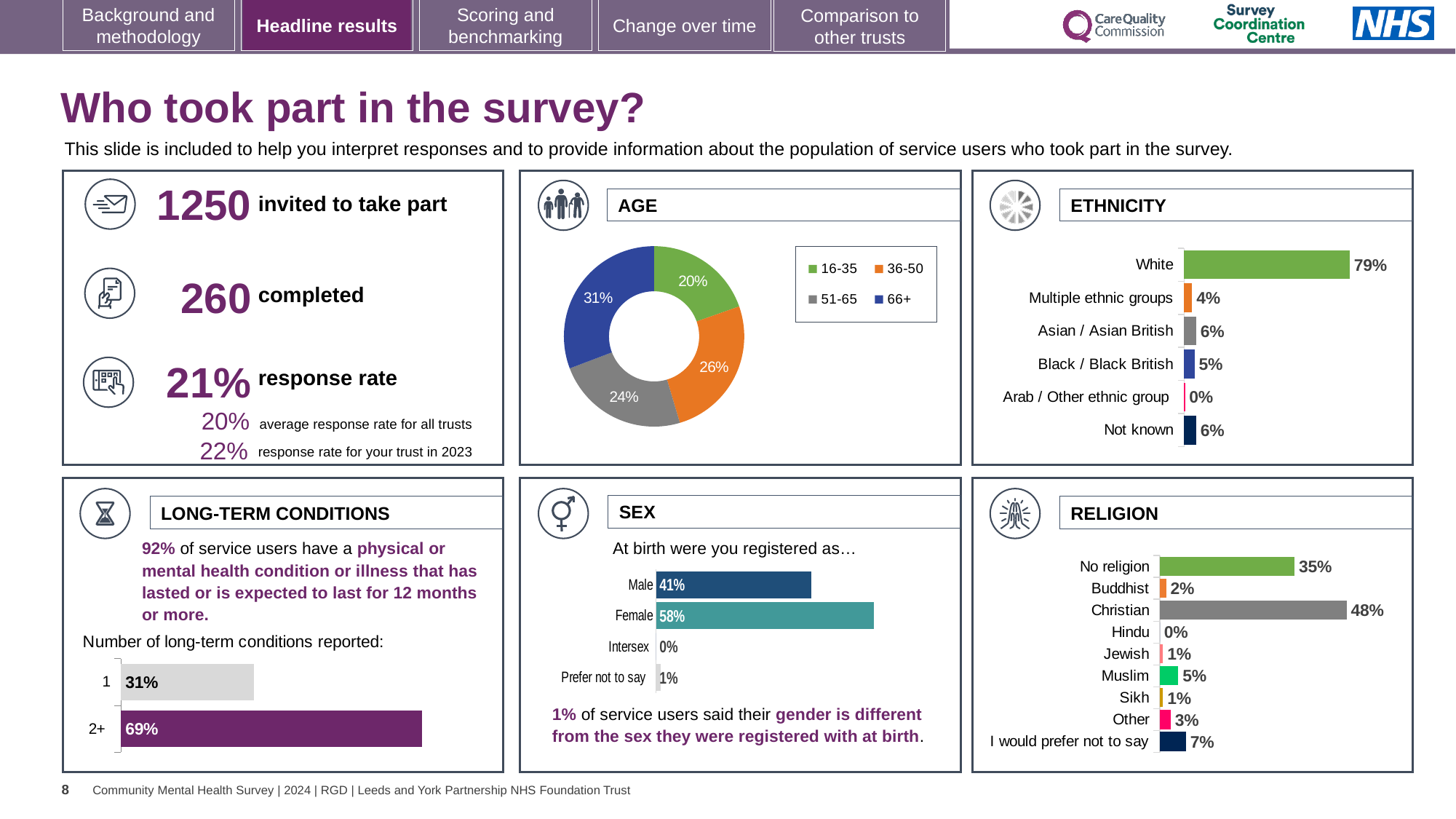
In the SEX chart, which is larger, Male or Female? Female In the ETHNICITY chart, what is the value for White? 79% In the AGE chart, what percentage of respondents were aged 66+? 31% In the AGE chart, which age group has the smallest share? 16-35 What kind of chart is the AGE chart? Doughnut chart In the RELIGION chart, what is the difference between Christian and No religion? 13% In the SEX chart, what is the value for Prefer not to say? 1% How many series does the legend of the AGE chart list? 4 In the LONG-TERM CONDITIONS chart, what percentage reported 2+ conditions? 69% In the ETHNICITY chart, what is the difference between Asian / Asian British and Black / Black British? 1% In the RELIGION chart, which category has the highest value? Christian How many categories are shown in the ETHNICITY chart? 6